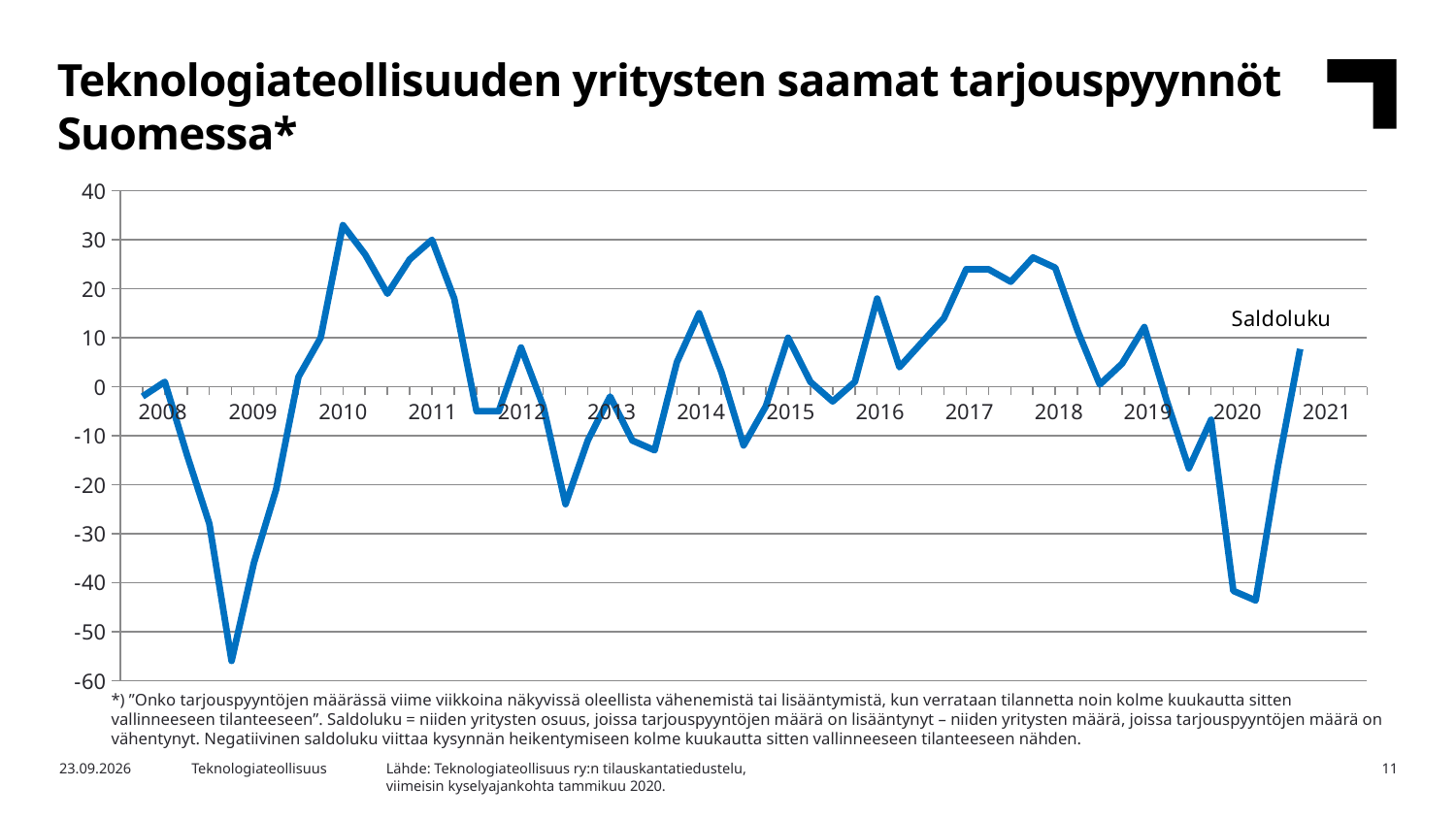
Is the peak value of the line around 2010 greater or less than 30? greater What is the name of the series plotted on the chart? Saldoluku Which is lower, the trough of the line in 2009 or the trough in 2020? 2009 What is the title of the chart on the slide? Teknologiateollisuuden yritysten saamat tarjouspyynnöt Suomessa* Is the lowest value of the line in 2020 greater or less than -40? less Is the peak value of the line around 2018 greater or less than 20? greater How many series does the chart show? 1 Does the line rise or fall between 2019 and the low point in 2020? fall How many year labels are shown on the x axis? 14 In which year does the line reach its lowest point? 2009 What kind of chart is shown on the slide? line chart